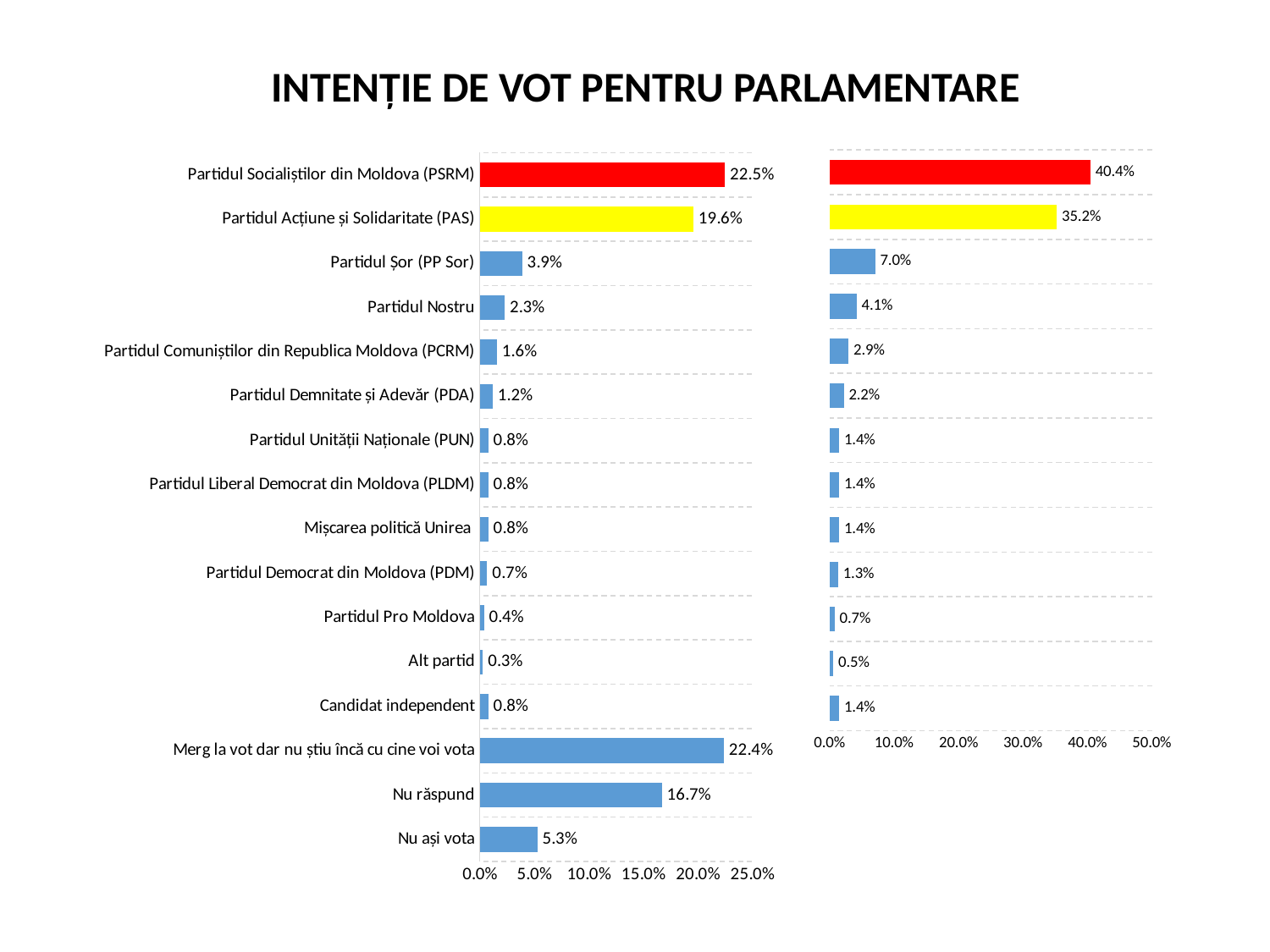
On the right chart, what is the value of the second (yellow) bar? 35.2% On the left chart, what is the difference between Partidul Socialiștilor din Moldova (PSRM) and Partidul Acțiune și Solidaritate (PAS)? 2.9% On the left chart, which category has the lowest value? Alt partid On the left chart, which category has the highest value? Partidul Socialiștilor din Moldova (PSRM) On the left chart, which is larger: Nu răspund or Nu aș vota? Nu răspund How many categories does the left chart show? 16 What is the title of the slide? INTENȚIE DE VOT PENTRU PARLAMENTARE On the left chart, what is the value for Partidul Socialiștilor din Moldova (PSRM)? 22.5% What type of chart is shown on the left? Bar chart How many bars does the right chart show? 13 On the right chart, what is the value of the top (red) bar? 40.4% On the left chart, what is the value for Merg la vot dar nu știu încă cu cine voi vota? 22.4%